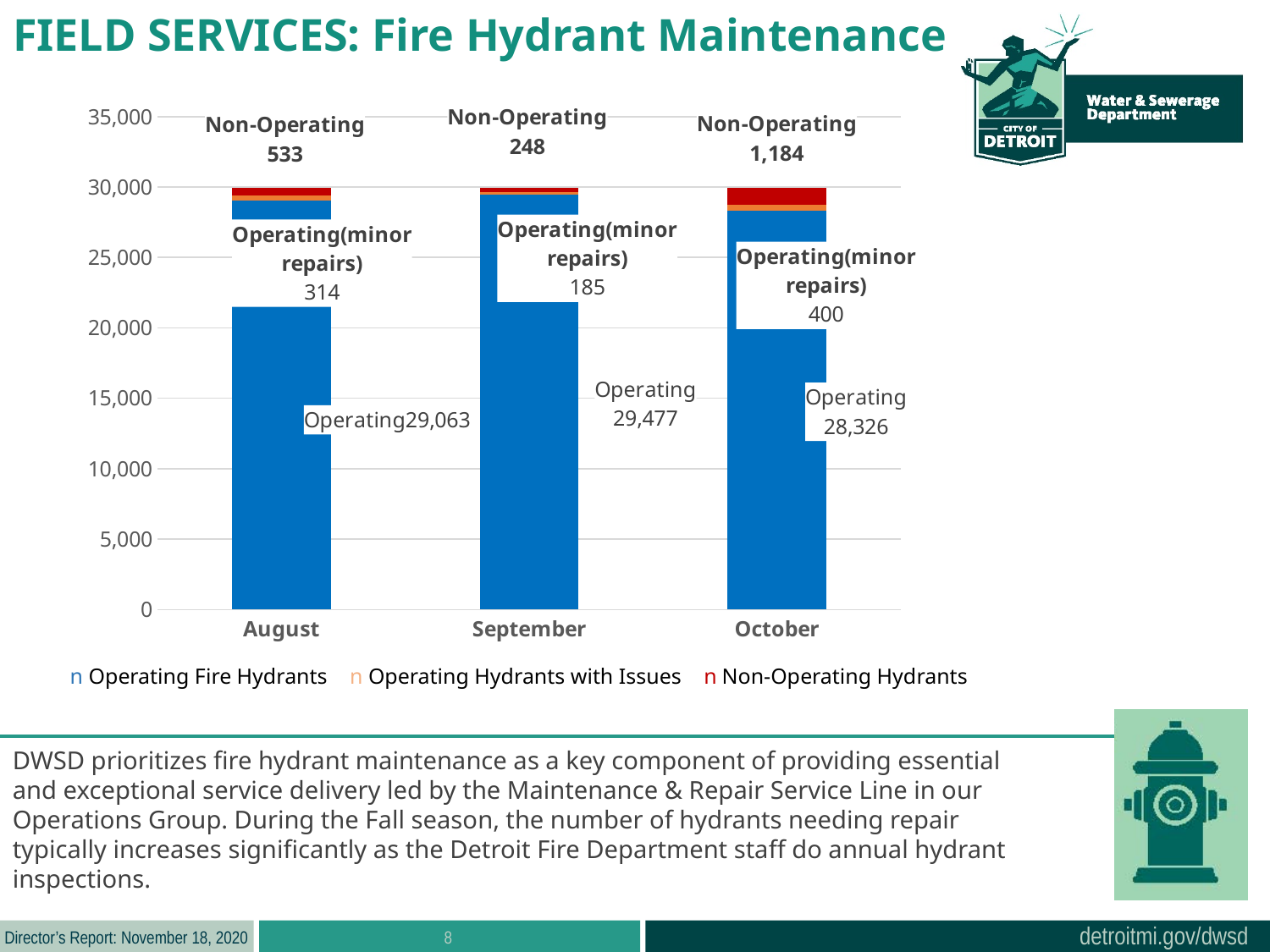
Which series is shown in blue in the chart legend? Operating Fire Hydrants What is the total of the stacked bar for August? 29,910 What is the difference between the Non-Operating counts for October and September? 936 What is the Non-Operating hydrant count for October? 1,184 What is the number of Operating fire hydrants in September? 29,477 Which is larger, the Operating count for August or for October? August What is the Operating (minor repairs) value for August? 314 How many series does the chart legend list? 3 What type of chart is shown on the slide? Stacked bar chart Which month has the highest Non-Operating hydrant count? October Which month has the lowest Operating (minor repairs) value? September How many months are shown on the x axis of the chart? 3